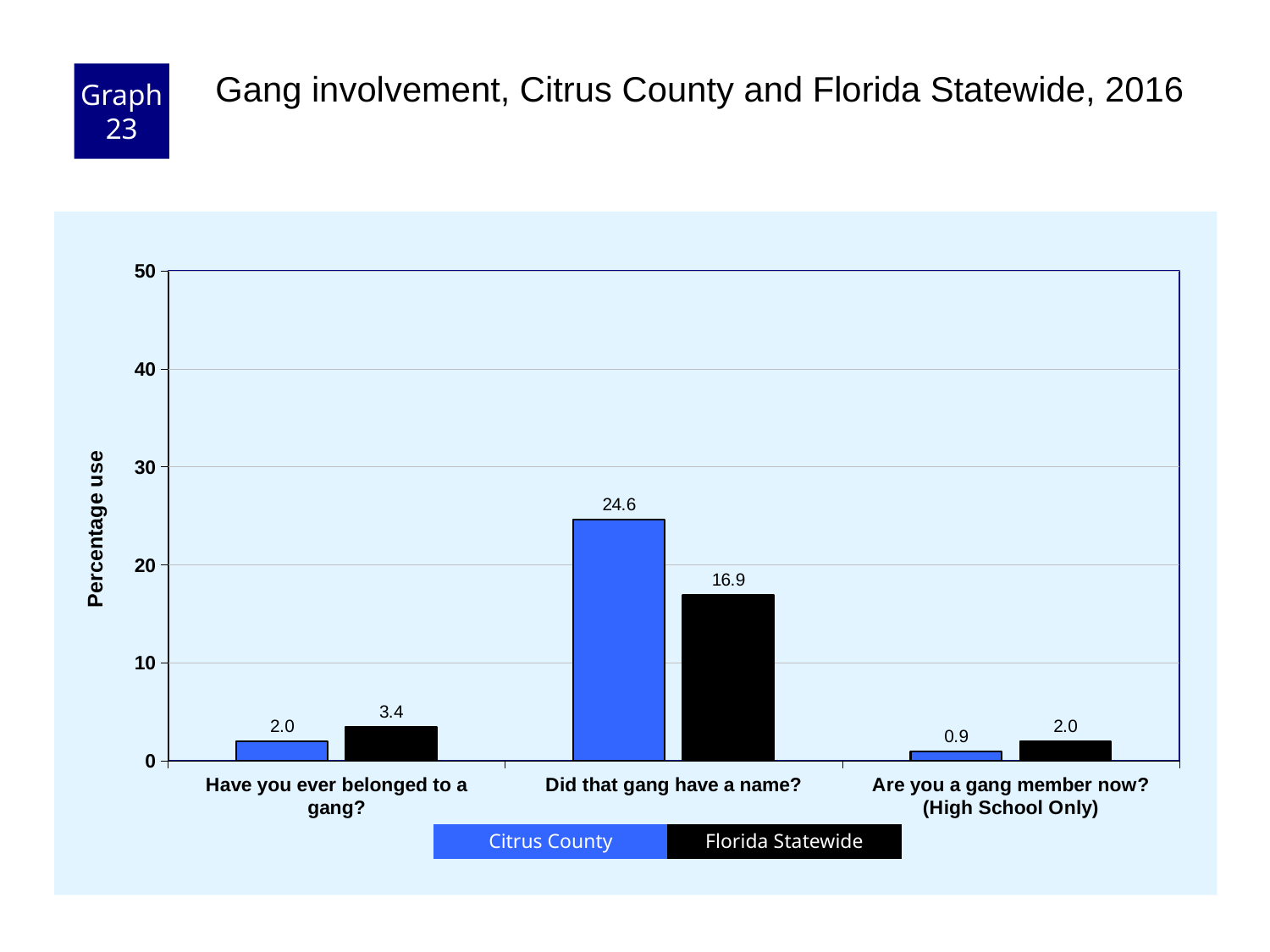
Which question has the lowest Florida Statewide value? Are you a gang member now? (High School Only) What is the label on the y axis? Percentage use Is the Florida Statewide value for "Did that gang have a name?" greater or less than 20? less What is the difference between the Citrus County and Florida Statewide values for "Did that gang have a name?"? 7.7 Which question has the highest Citrus County value? Did that gang have a name? How many series does the legend list? 2 For "Have you ever belonged to a gang?", which is larger: Citrus County or Florida Statewide? Florida Statewide How many questions (categories) are shown on the x axis? 3 What kind of chart is shown? Bar chart What is the Citrus County value for "Are you a gang member now? (High School Only)"? 0.9 What is the Florida Statewide value for "Have you ever belonged to a gang?"? 3.4 What is the Citrus County value for "Did that gang have a name?"? 24.6